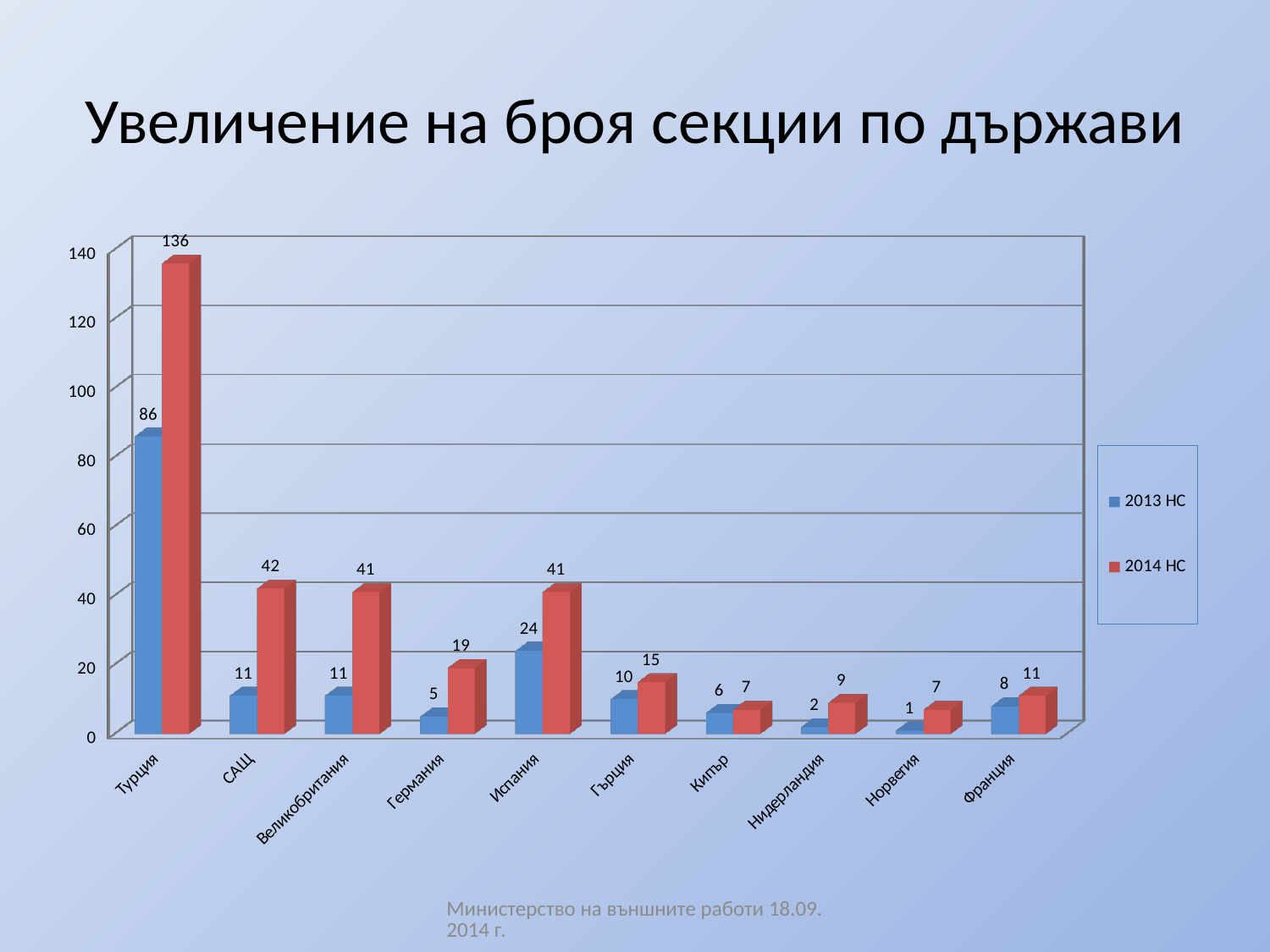
How many countries are shown on the x axis? 10 What is the value for Нидерландия in the 2014 НС series? 9 Which country has the lowest value in the 2013 НС series? Норвегия Which is larger: the 2013 НС value for Испания or the 2013 НС value for Гърция? Испания What kind of chart is shown on the slide? Bar chart What is the value for Испания in the 2013 НС series? 24 What is the title of the chart? Увеличение на броя секции по държави How many series does the legend list? 2 What is the difference between the 2014 НС and 2013 НС values for Турция? 50 What is the value for Турция in the 2014 НС series? 136 What is the difference between the 2014 НС and 2013 НС values for САЩ? 31 Which country has the highest value in the 2014 НС series? Турция